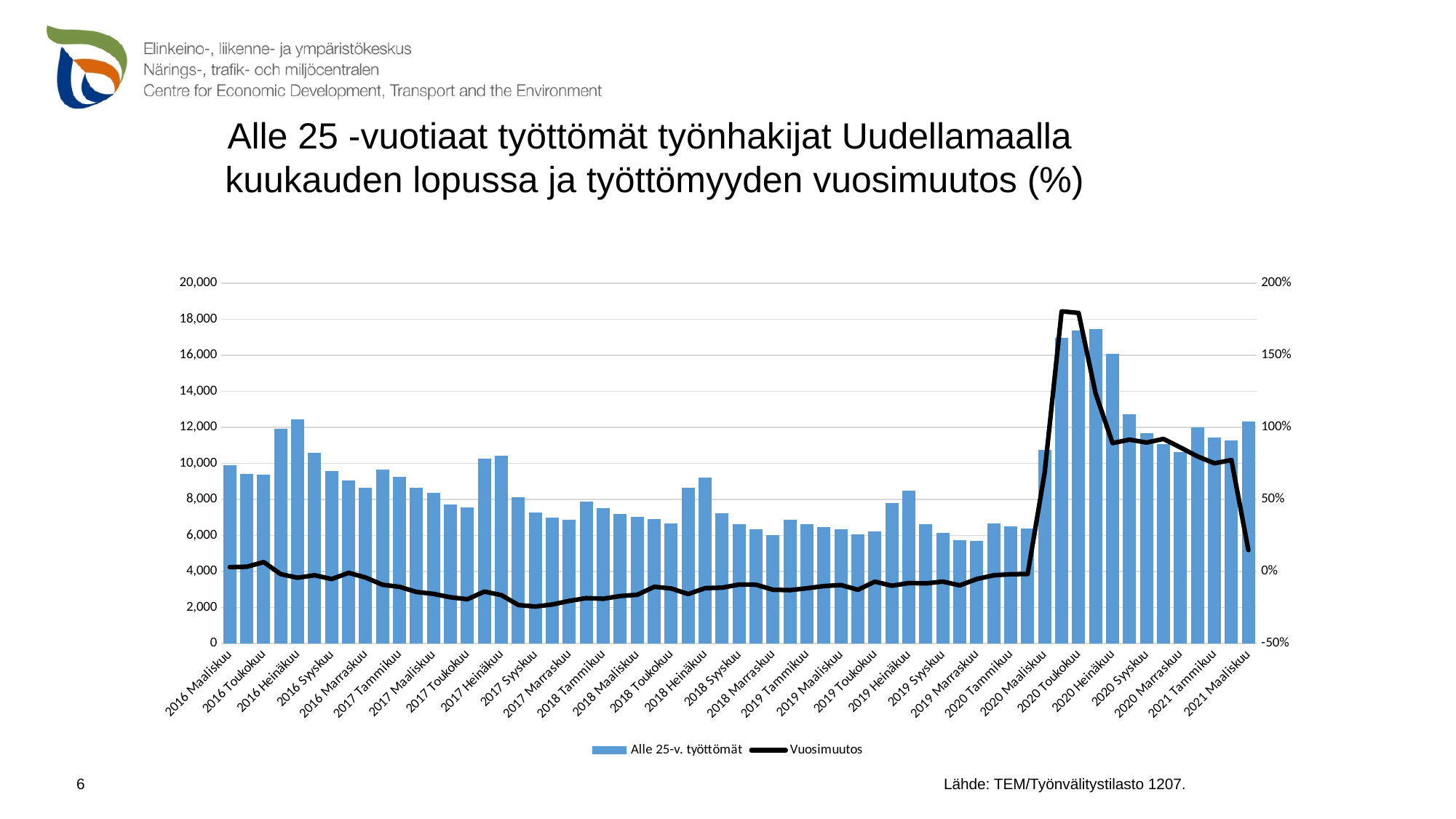
Is the bar value for 2018 Heinäkuu greater or less than 10,000? less Is the bar value for 2019 Maaliskuu greater or less than 8,000? less What are the two series named in the legend? Alle 25-v. työttömät and Vuosimuutos Which series is drawn as a black line? Vuosimuutos Is the bar value for 2020 Toukokuu greater or less than 16,000? greater How many series does the legend list? 2 Do the bars rise or fall from 2020 Heinäkuu to 2020 Marraskuu? fall What kind of chart is shown on the slide? A combined bar and line chart Which has the taller bar, 2016 Heinäkuu or 2016 Maaliskuu? 2016 Heinäkuu In which year do the bars for Alle 25-v. työttömät reach their highest value? 2020